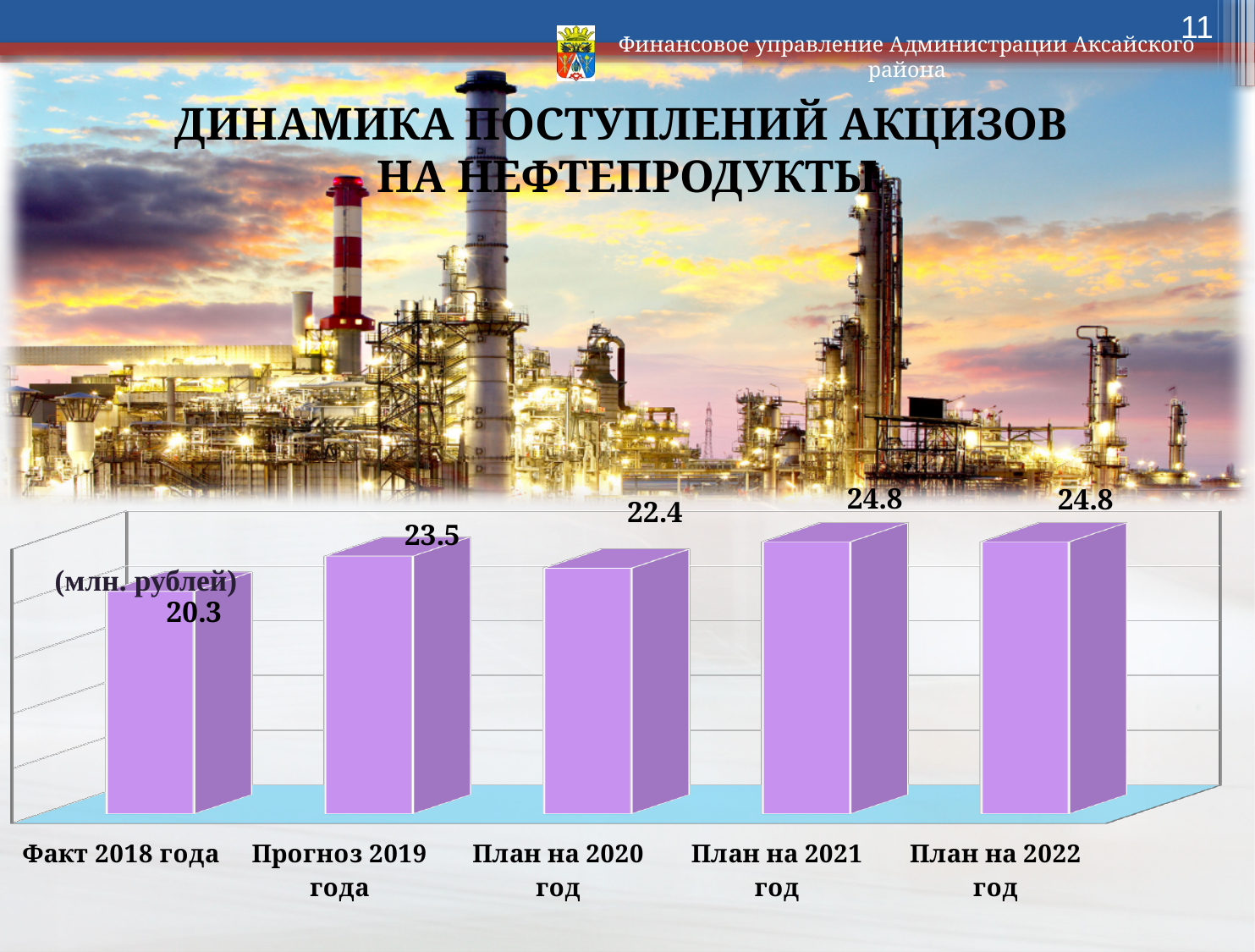
What is the difference between the values for План на 2021 год and Факт 2018 года? 4.5 In what units are the values on the chart expressed? млн. рублей What kind of chart is shown on the slide? Bar chart Which category has the lowest value? Факт 2018 года What is the value for План на 2021 год? 24.8 How many categories are shown on the chart? 5 What is the value for План на 2020 год? 22.4 What is the value for Факт 2018 года? 20.3 Which is larger, the value for Прогноз 2019 года or the value for План на 2020 год? Прогноз 2019 года What is the highest value shown on the chart? 24.8 What is the value for Прогноз 2019 года? 23.5 What is the difference between the values for Прогноз 2019 года and План на 2020 год? 1.1